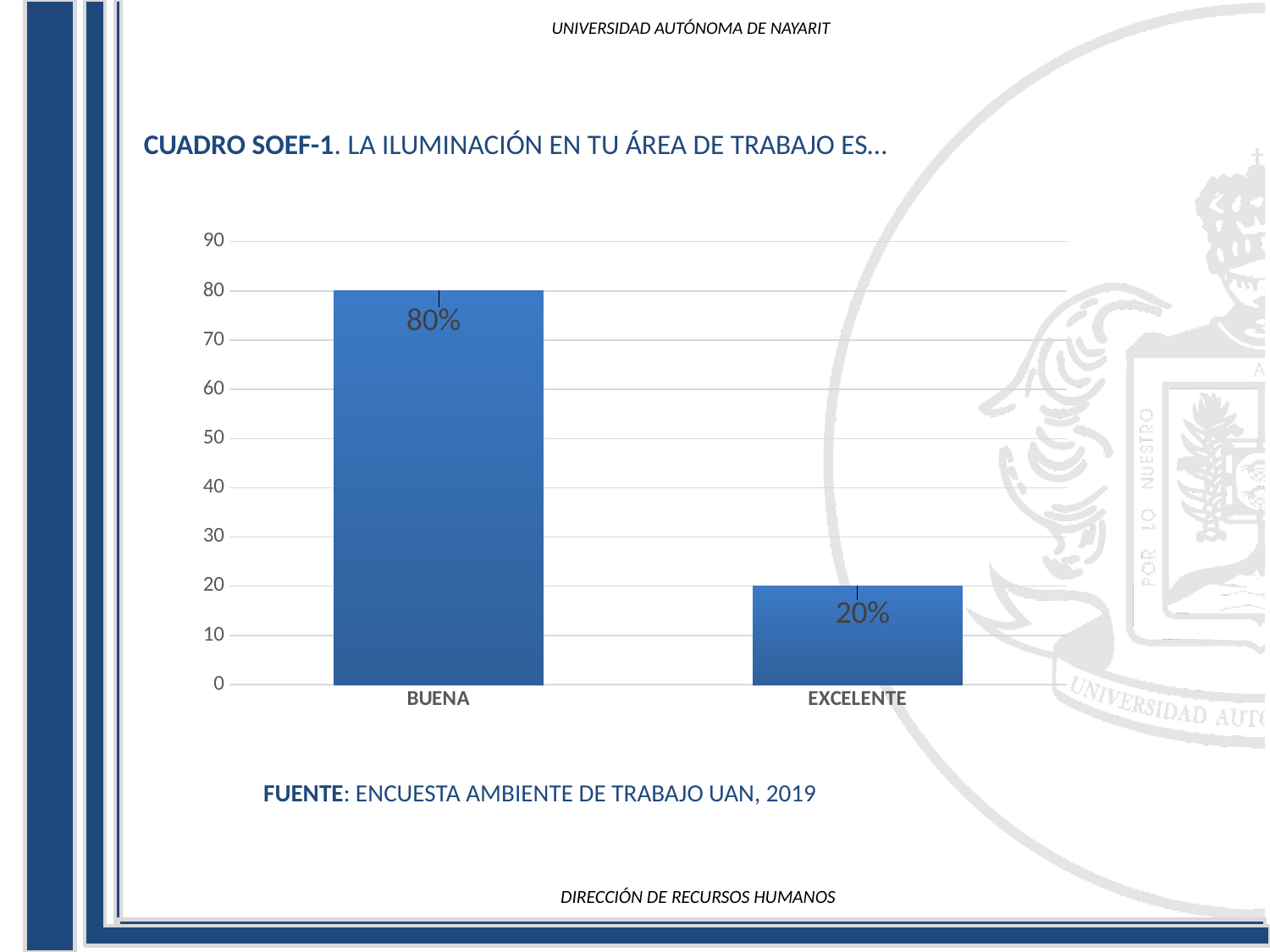
Which category has the highest value? BUENA What is the source cited below the chart? ENCUESTA AMBIENTE DE TRABAJO UAN, 2019 How many categories are shown on the x axis? 2 What is the difference between the values for BUENA and EXCELENTE? 60% What is the value for BUENA? 80% What is the value for EXCELENTE? 20% Is the value for EXCELENTE greater or less than 30? less Which is larger, the value for BUENA or the value for EXCELENTE? BUENA Is the value for BUENA greater or less than 50? greater Do the values rise or fall from BUENA to EXCELENTE? fall Which category has the lowest value? EXCELENTE What kind of chart is shown on the slide? bar chart